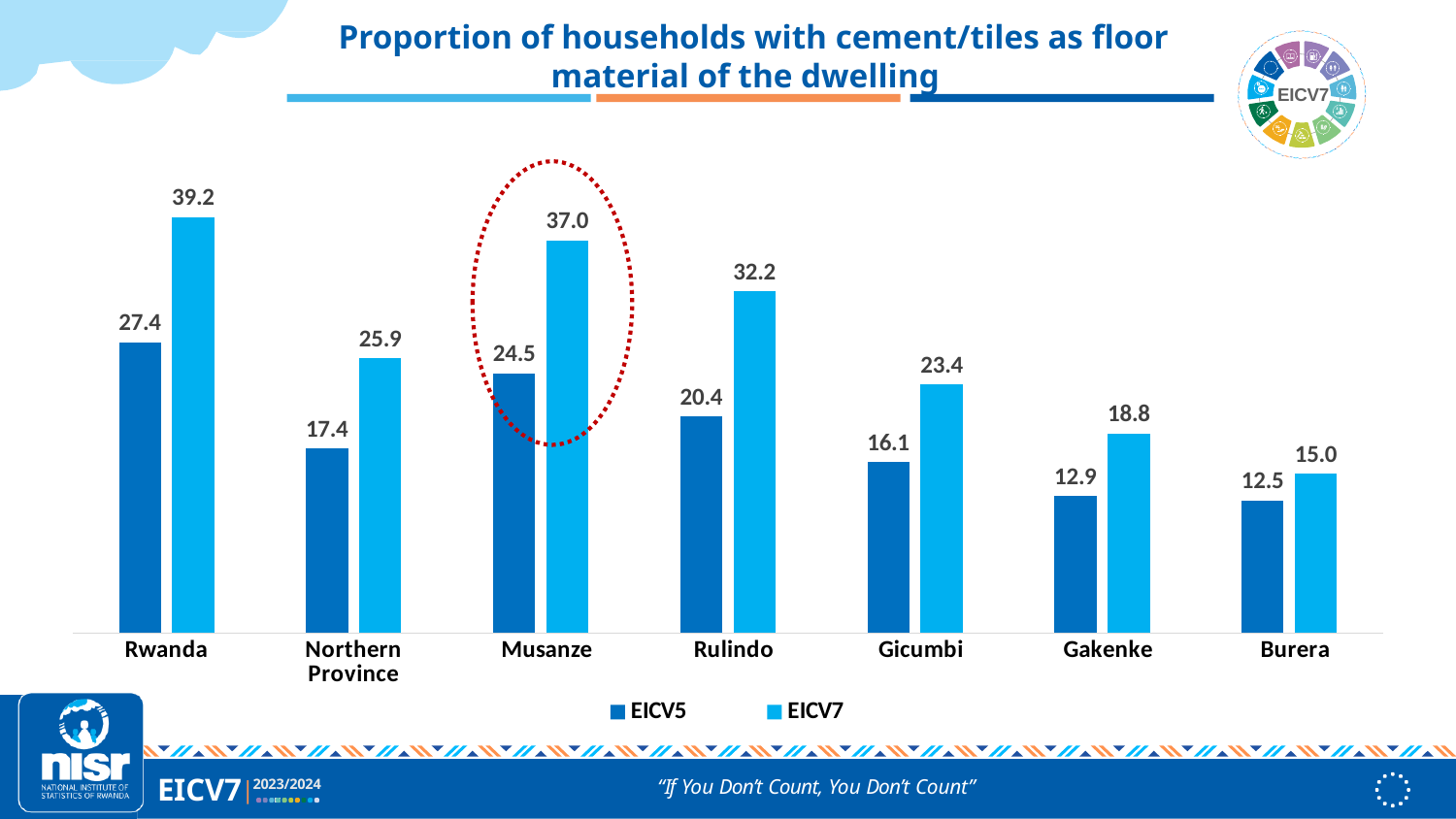
What is the EICV5 value for Gicumbi? 16.1 Which is larger, the EICV7 value for Rulindo or the EICV7 value for Gicumbi? Rulindo What is the difference between the EICV7 and EICV5 values for Northern Province? 8.5 How many series does the legend list? 2 How many categories are shown on the x axis? 7 What is the difference between the EICV7 values for Rwanda and Burera? 24.2 What is the EICV7 value for Musanze? 37.0 Which category has the highest EICV7 value? Rwanda Which category is highlighted with a dotted red circle? Musanze Which category has the lowest EICV5 value? Burera What is the EICV7 value for Rwanda? 39.2 What kind of chart is shown on the slide? Bar chart